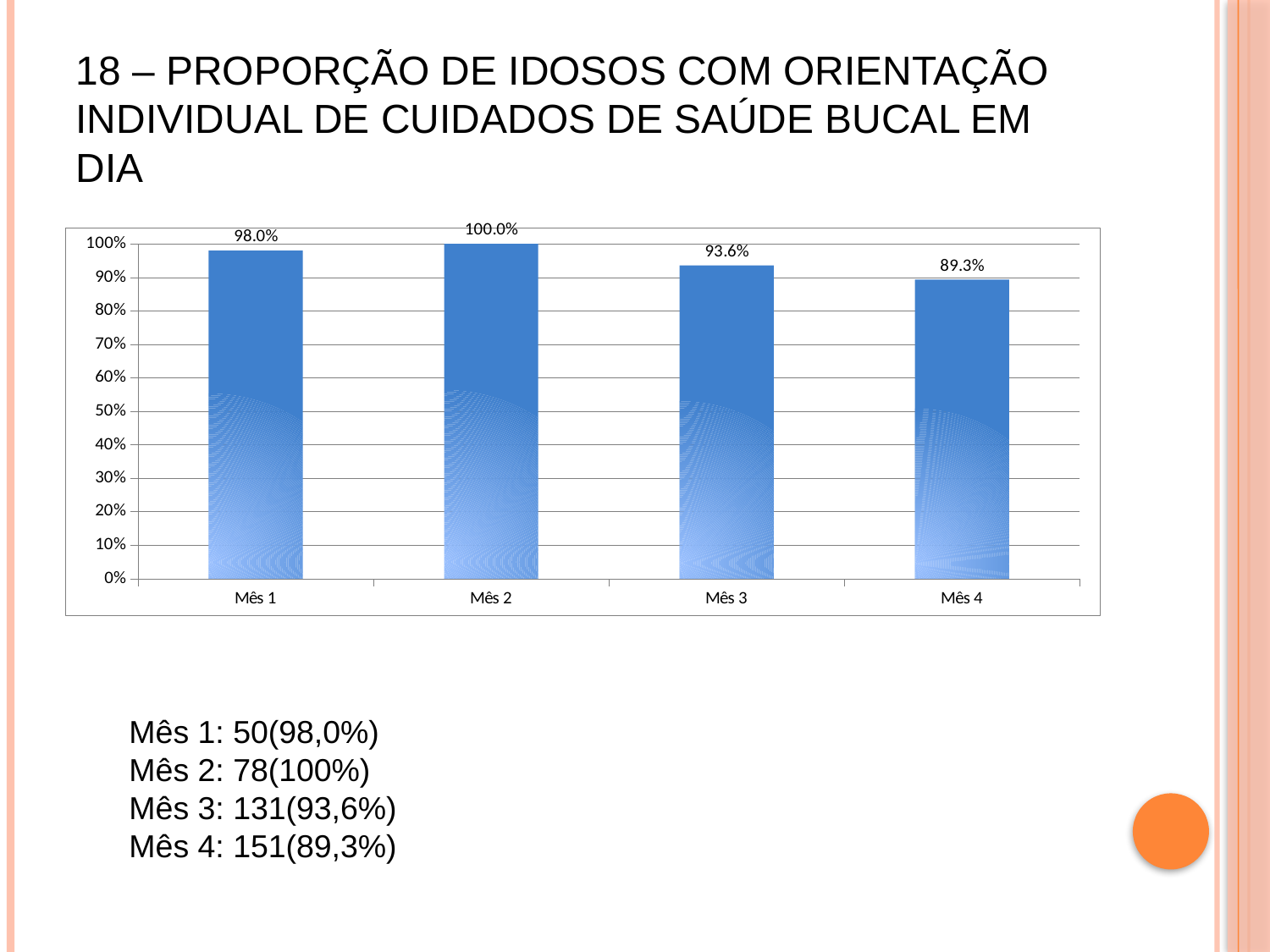
Do the values rise or fall from Mês 2 to Mês 4? fall How many months are shown on the x axis? 4 What is the difference between the values for Mês 1 and Mês 3? 4.4% What is the difference between the values for Mês 2 and Mês 4? 10.7% What is the value for Mês 4? 89.3% Which month has the lowest value? Mês 4 Is the value for Mês 4 greater or less than 90%? less What kind of chart is shown on the slide? bar chart Which is larger, the value for Mês 3 or the value for Mês 4? Mês 3 Which month has the highest value? Mês 2 What is the value for Mês 1? 98.0% What is the value for Mês 3? 93.6%